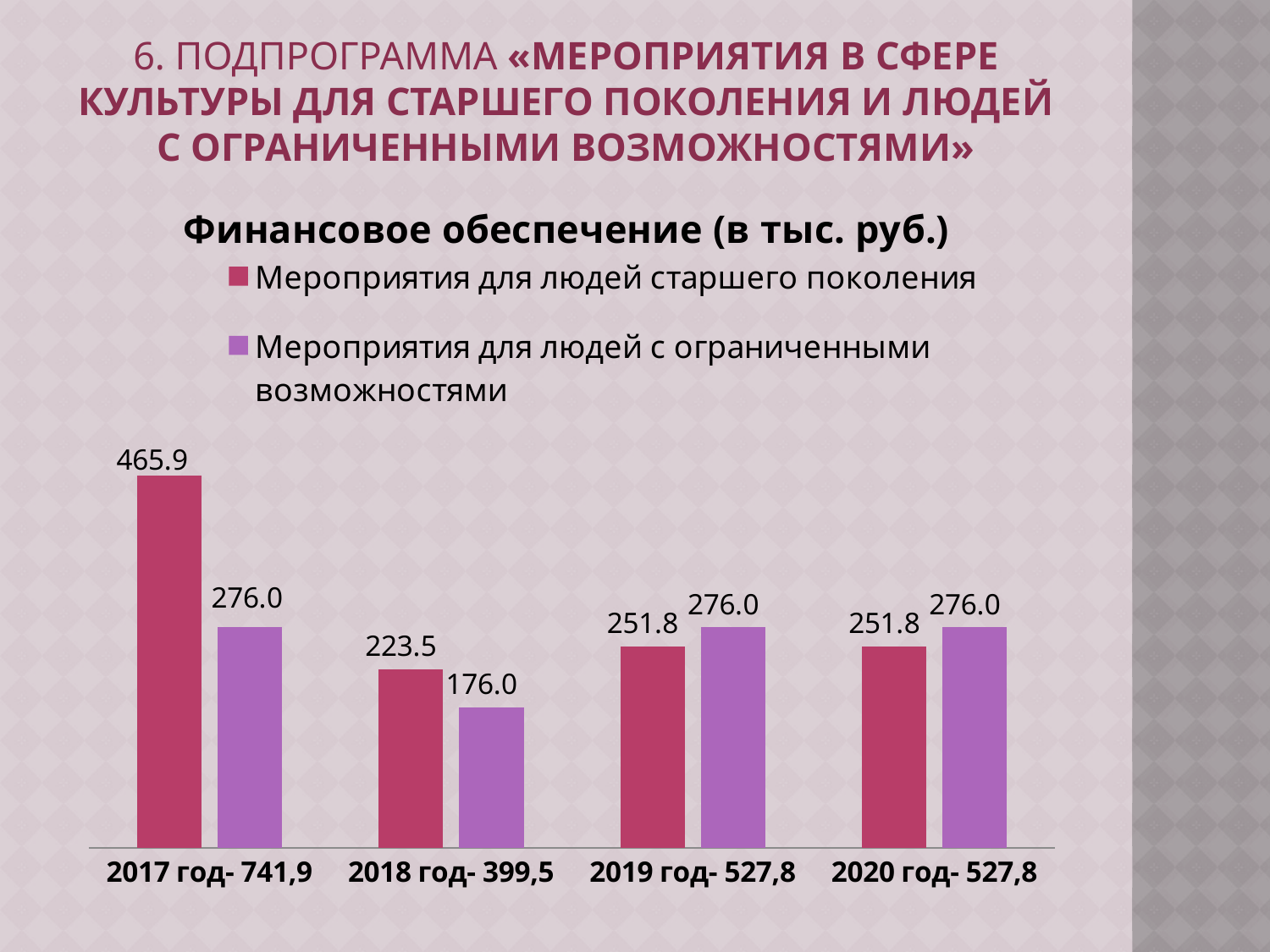
What is the value for «Мероприятия для людей с ограниченными возможностями» in 2018? 176.0 What is the value for «Мероприятия для людей старшего поколения» in 2019? 251.8 How many series does the legend list? 2 What kind of chart is shown on the slide? Bar chart In 2019, which series has the larger value? Мероприятия для людей с ограниченными возможностями How many years (categories) are shown on the x axis? 4 What is the value for «Мероприятия для людей старшего поколения» in 2017? 465.9 In which year is the value for «Мероприятия для людей старшего поколения» highest? 2017 What is the difference between the 2017 and 2018 values for «Мероприятия для людей старшего поколения»? 242.4 In which year is the value for «Мероприятия для людей с ограниченными возможностями» lowest? 2018 What is the difference between the two series' values in 2017? 189.9 What is the title of the chart? Финансовое обеспечение (в тыс. руб.)